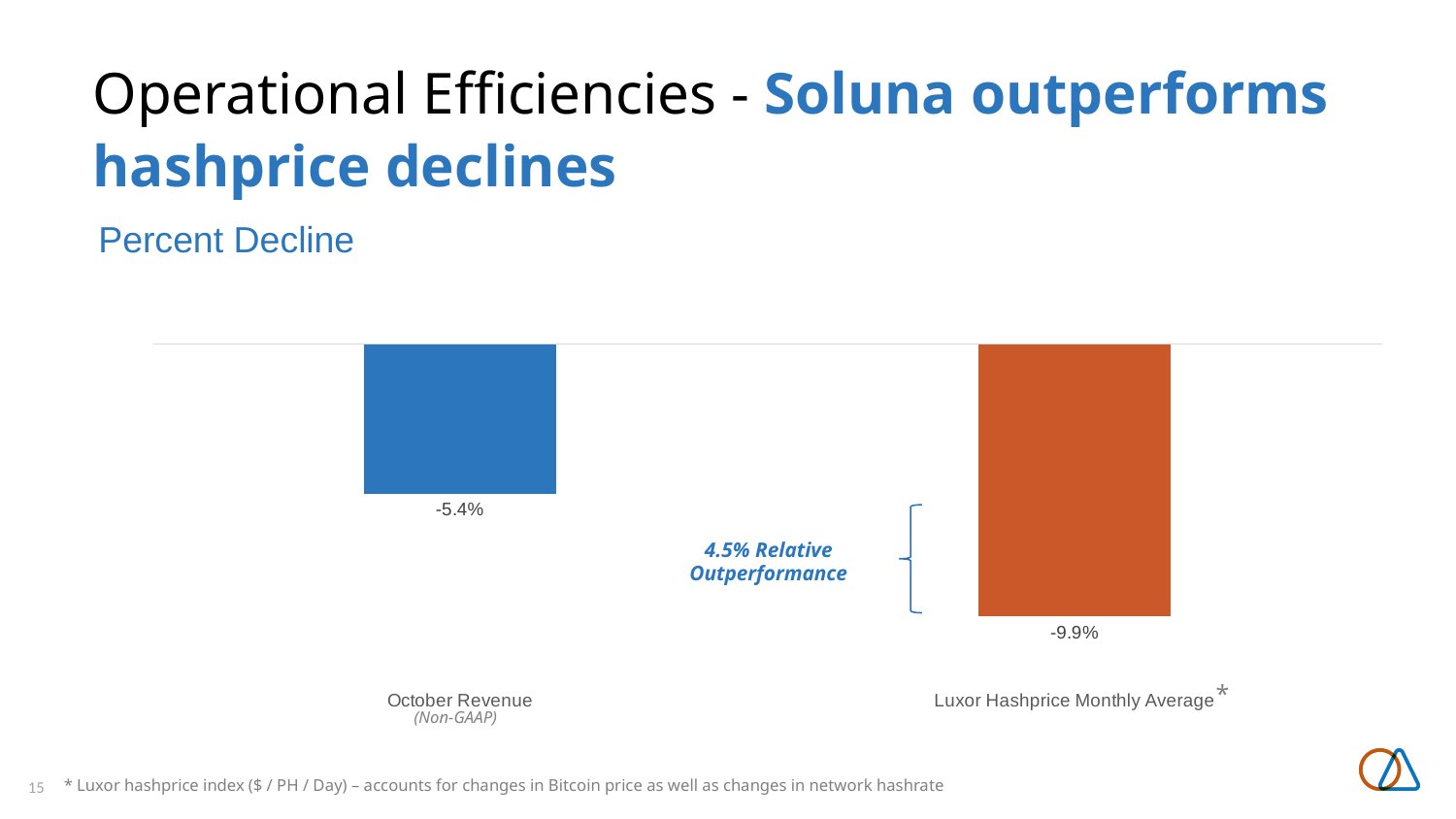
Which category shows the smaller percent decline? October Revenue (Non-GAAP) Which category shows the larger percent decline? Luxor Hashprice Monthly Average What kind of chart is shown on the slide? bar chart How many categories are plotted in the chart? 2 What colour is the bar for Luxor Hashprice Monthly Average? orange What is the value shown for October Revenue (Non-GAAP)? -5.4% Is the decline for October Revenue larger or smaller than the decline for Luxor Hashprice Monthly Average? smaller What is the title of the chart? Percent Decline What is the value shown for Luxor Hashprice Monthly Average? -9.9% What relative outperformance is annotated between the two bars? 4.5% Relative Outperformance What is the difference between the October Revenue decline and the Luxor Hashprice Monthly Average decline? 4.5%